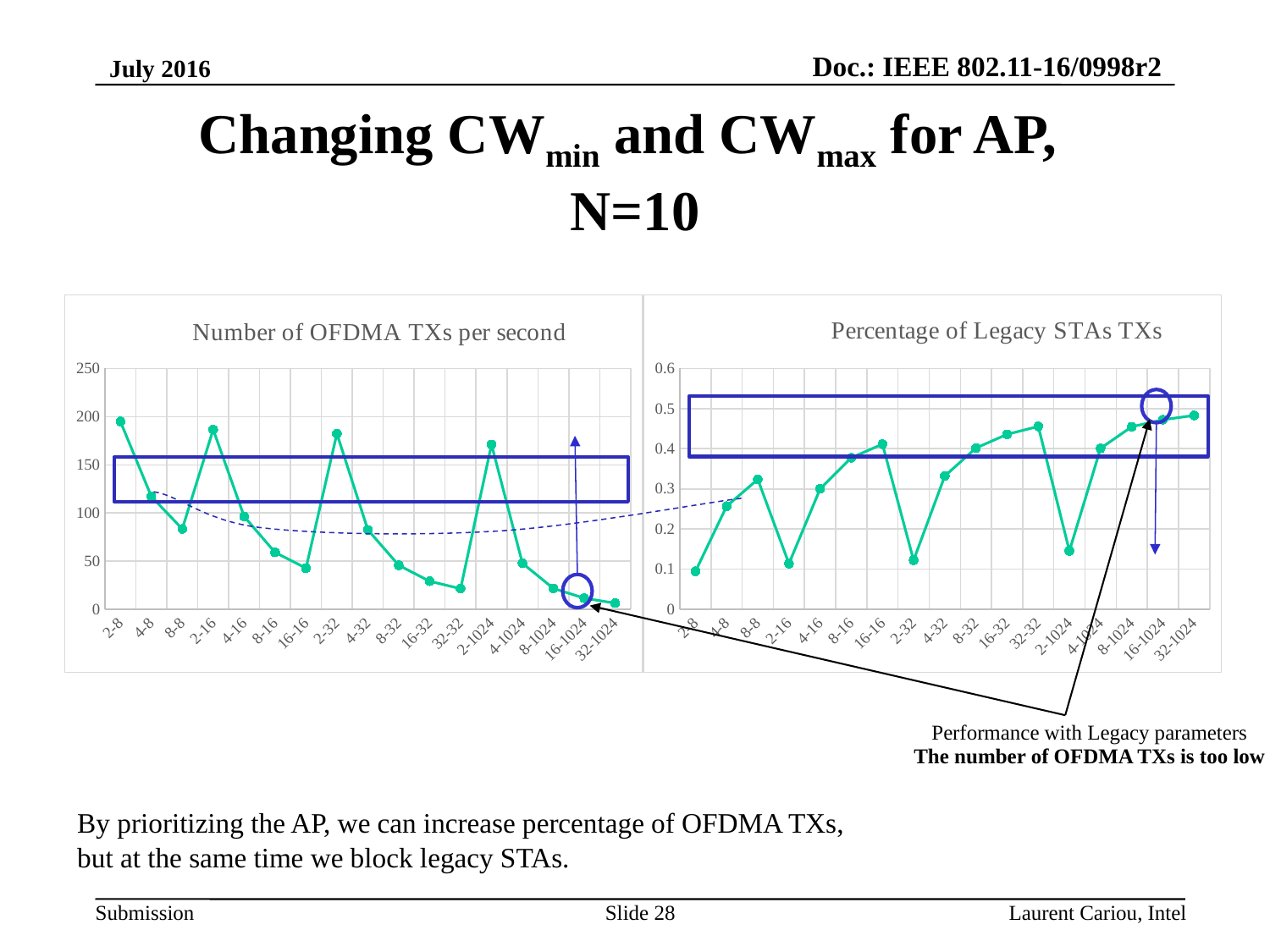
How many categories are shown on the x axis of the 'Number of OFDMA TXs per second' chart? 17 In the 'Number of OFDMA TXs per second' chart, is the value for 2-8 greater or less than 150? greater What kind of chart is the 'Percentage of Legacy STAs TXs' chart? line chart What kind of chart is the 'Number of OFDMA TXs per second' chart? line chart In the 'Percentage of Legacy STAs TXs' chart, do the values rise or fall from 2-1024 to 16-1024? rise In the 'Percentage of Legacy STAs TXs' chart, is the value for 32-1024 greater or less than 0.4? greater In the 'Number of OFDMA TXs per second' chart, which is larger, the value for 2-8 or the value for 8-8? 2-8 In the 'Percentage of Legacy STAs TXs' chart, is the value for 2-8 greater or less than 0.2? less In the 'Percentage of Legacy STAs TXs' chart, which is larger, the value for 16-16 or the value for 2-32? 16-16 In the 'Number of OFDMA TXs per second' chart, which is larger, the value for 2-1024 or the value for 4-1024? 2-1024